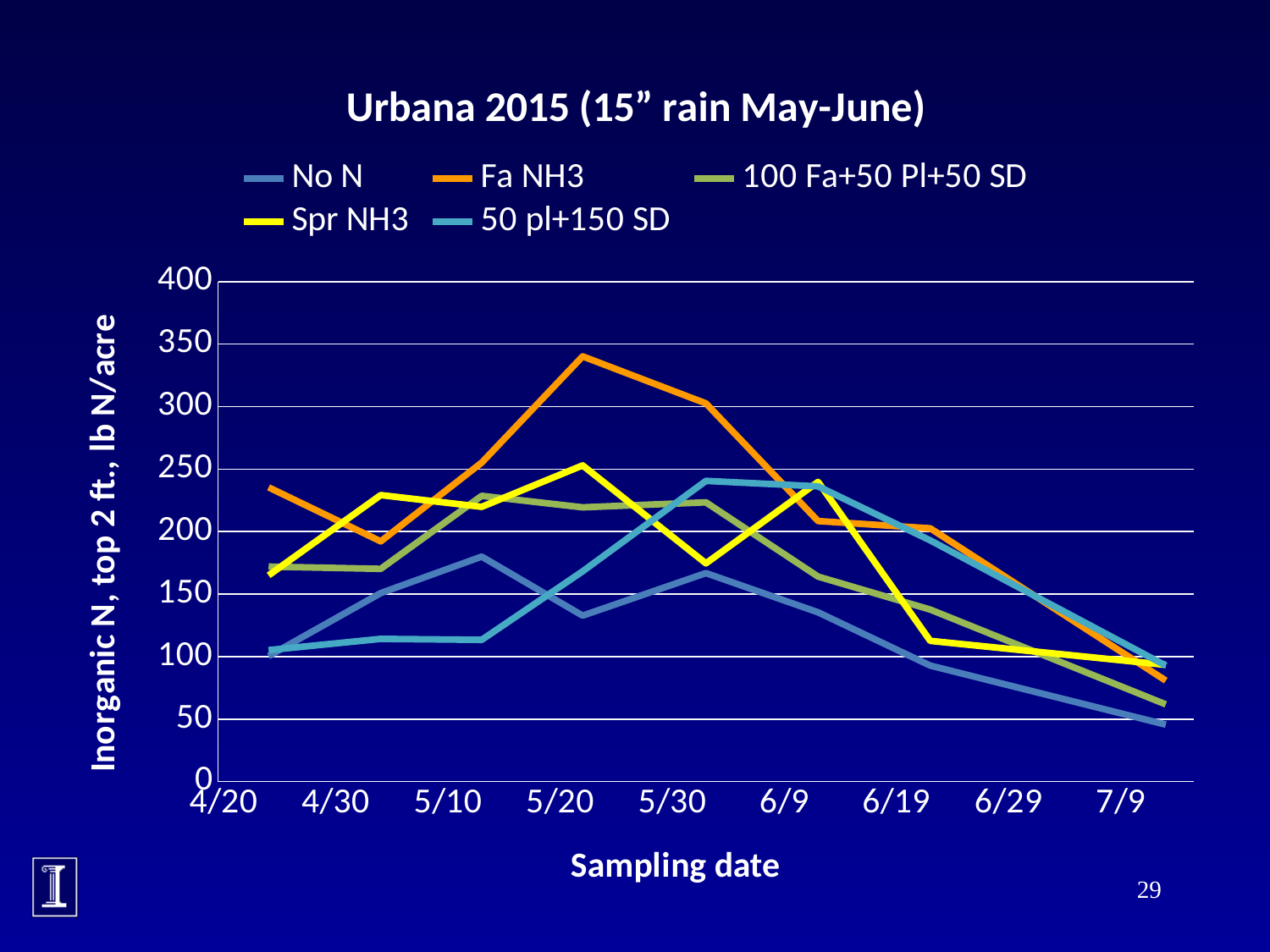
How many date labels are shown on the x axis? 9 Is the peak value of the Fa NH3 series greater or less than 300? greater Is the first value of the Fa NH3 series greater or less than 200? greater Which series has the lowest value at the last sampling date? No N How many series does the legend list? 5 At the first sampling date, which series has the larger value, Fa NH3 or No N? Fa NH3 Which series reaches the highest value on the chart? Fa NH3 Which series is drawn in orange? Fa NH3 What kind of chart is shown on the slide? Line chart Is the value of the No N series at the last sampling date greater or less than 100? less Does the Fa NH3 series rise or fall from its peak to the last sampling date? Fall What is the title of the chart? Urbana 2015 (15" rain May-June)